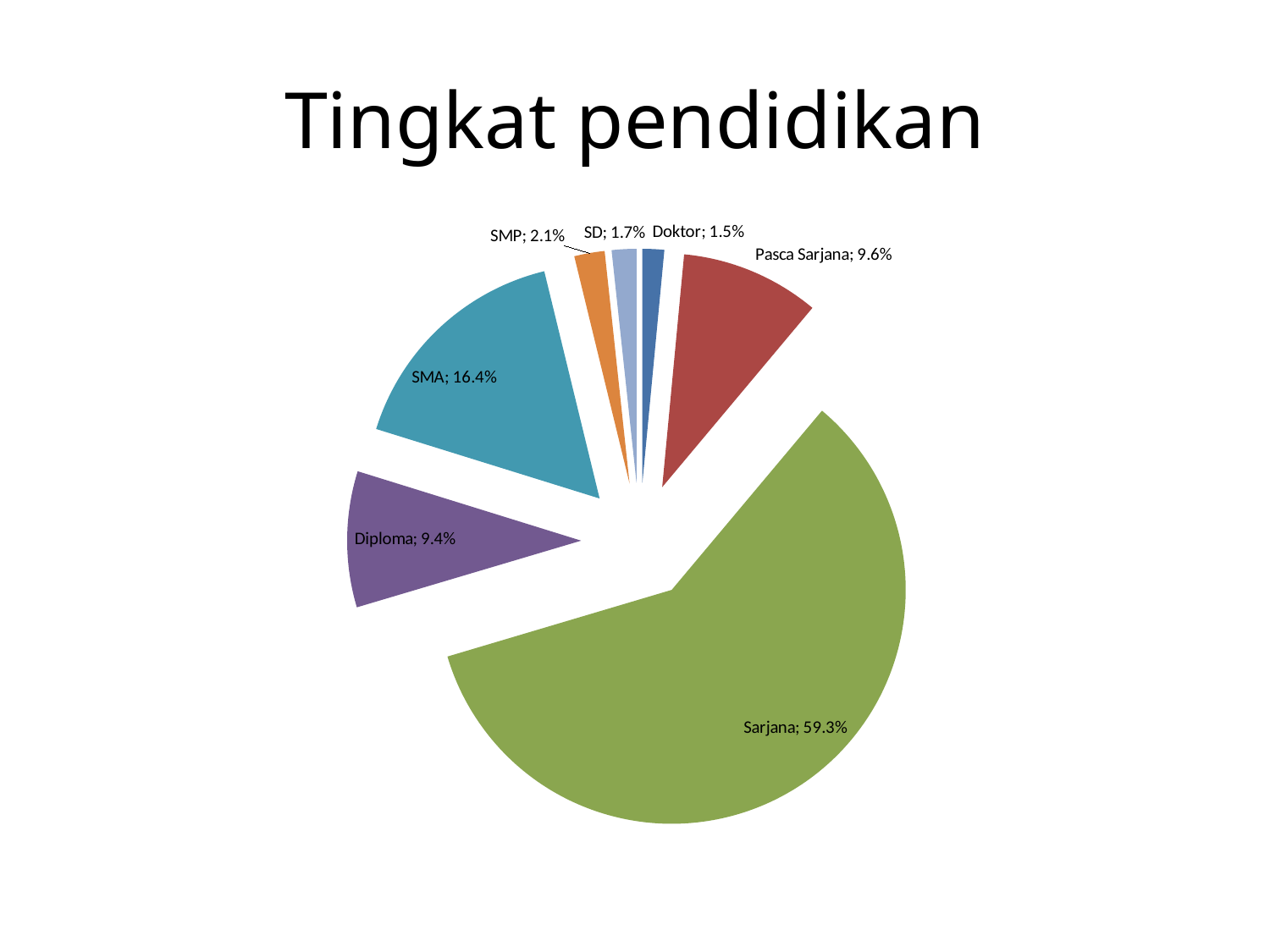
How many categories are shown in the pie chart? 7 What is the share for Doktor? 1.5% What is the title of the chart? Tingkat pendidikan Which category has the largest slice? Sarjana What is the share for SMA? 16.4% What is the difference between the shares of SMA and Diploma? 7.0% What is the share for Sarjana? 59.3% Which is larger, the share for Pasca Sarjana or the share for Diploma? Pasca Sarjana What type of chart is shown on the slide? Pie chart What is the difference between the shares of SMP and SD? 0.4% Which category has the smallest slice? Doktor What is the share for Pasca Sarjana? 9.6%